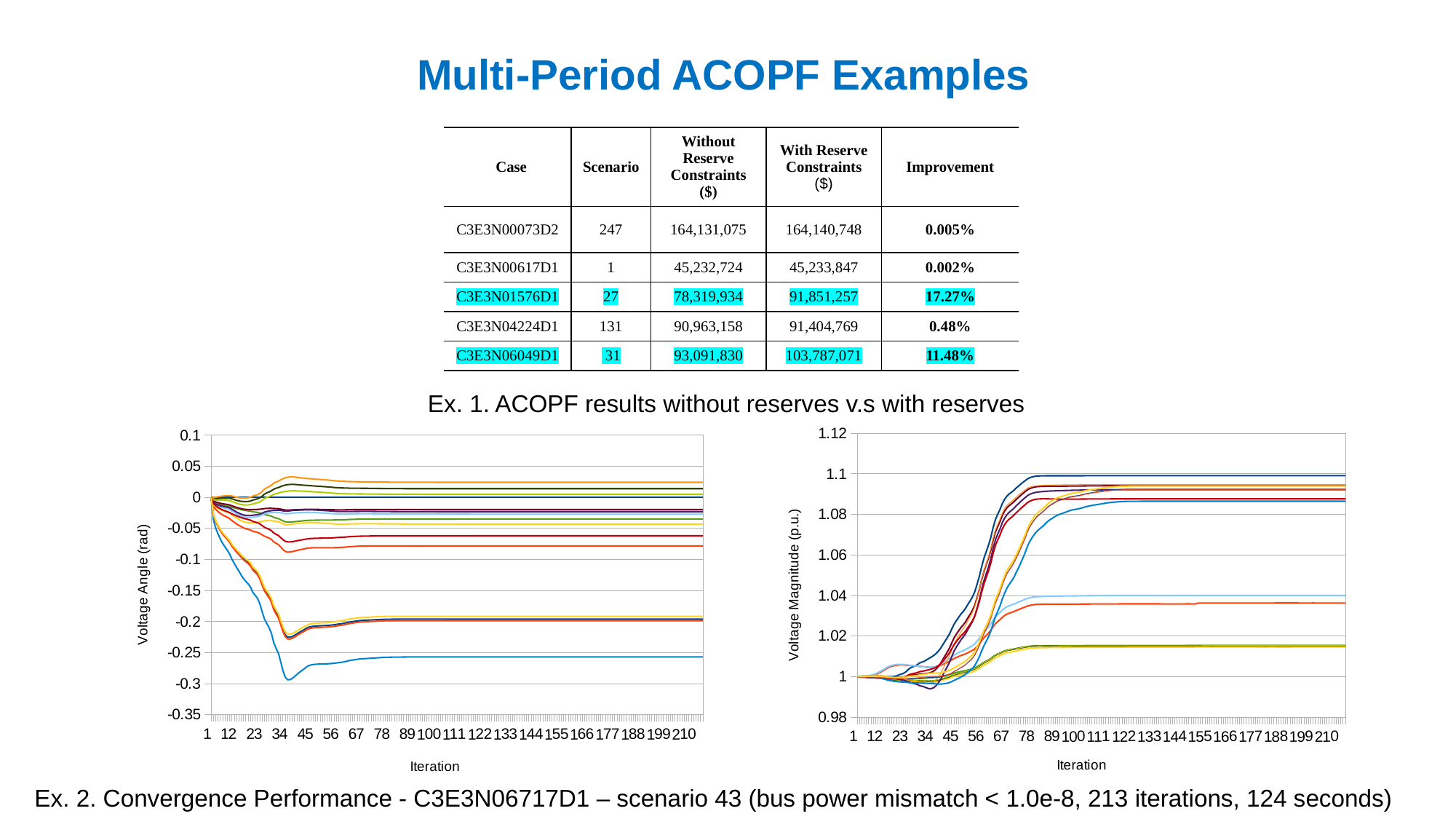
What is the last iteration label shown on the x-axis of the left chart? 210 In the right chart, is the value of the lowest line at iteration 210 greater or less than 1? greater In the left chart, does the lowest line rise or fall between iteration 1 and iteration 34? fall In the left chart, is the minimum value reached by the lowest line greater or less than -0.25? less In the right chart, do the lines generally rise or fall between iteration 34 and iteration 89? rise What kind of chart is the left chart (Voltage Angle vs Iteration)? line chart What kind of chart is the right chart (Voltage Magnitude vs Iteration)? line chart How many charts are shown on the slide? 2 What is the y-axis label of the left chart? Voltage Angle (rad) In the left chart, is the value of the highest line at iteration 210 greater or less than 0.05? less What is the y-axis label of the right chart? Voltage Magnitude (p.u.)